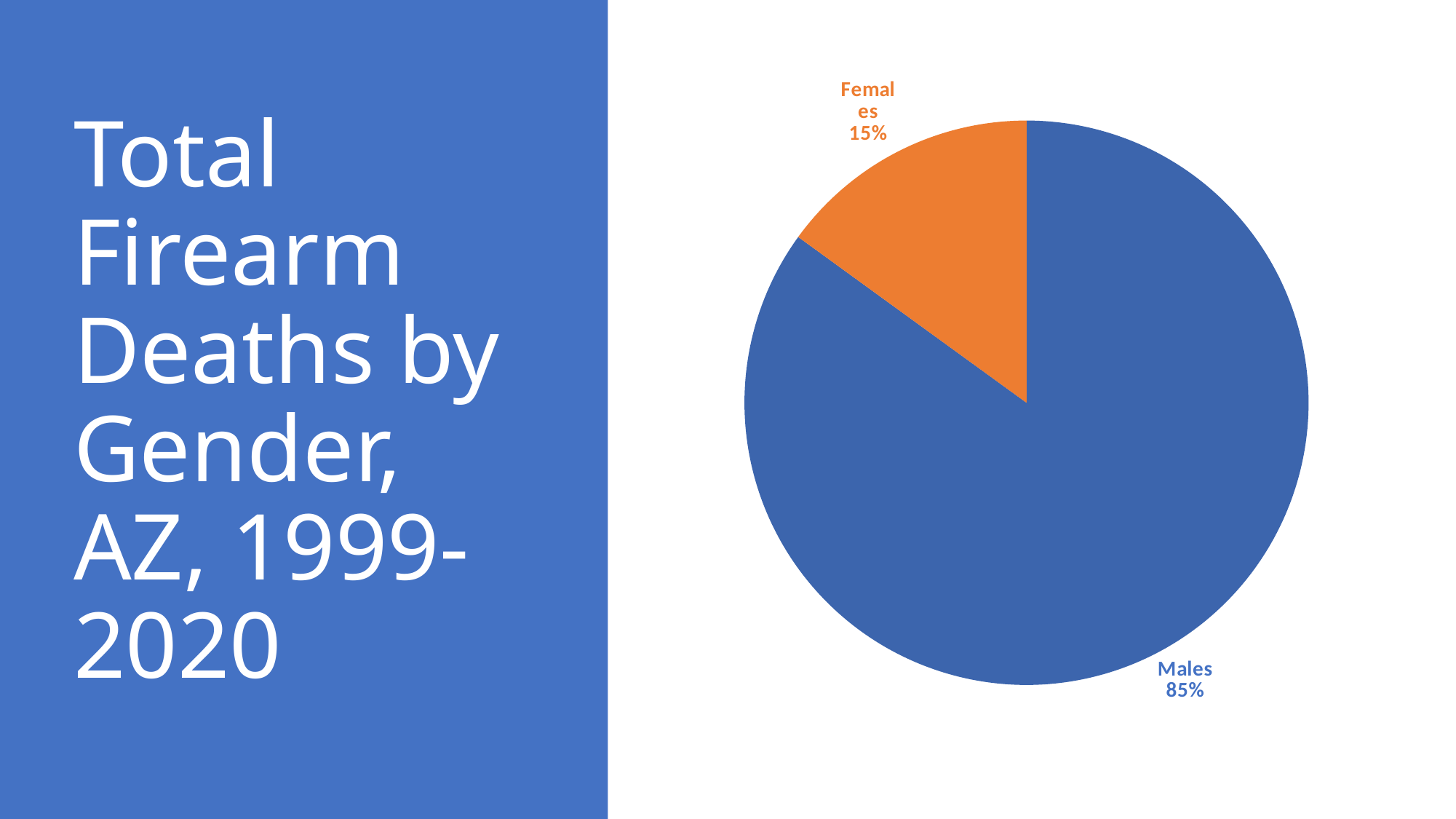
What kind of chart is shown on the slide? pie chart How many slices does the pie chart have? 2 What is the title of the slide containing the pie chart? Total Firearm Deaths by Gender, AZ, 1999-2020 What share of total firearm deaths is attributed to Females? 15% Which slice is larger, Males or Females? Males Which category has the smallest slice of the pie? Females What share of total firearm deaths is attributed to Males? 85% What is the difference in percentage points between the Males and Females slices? 70 What colour is the Females slice? orange Which category has the largest slice of the pie? Males